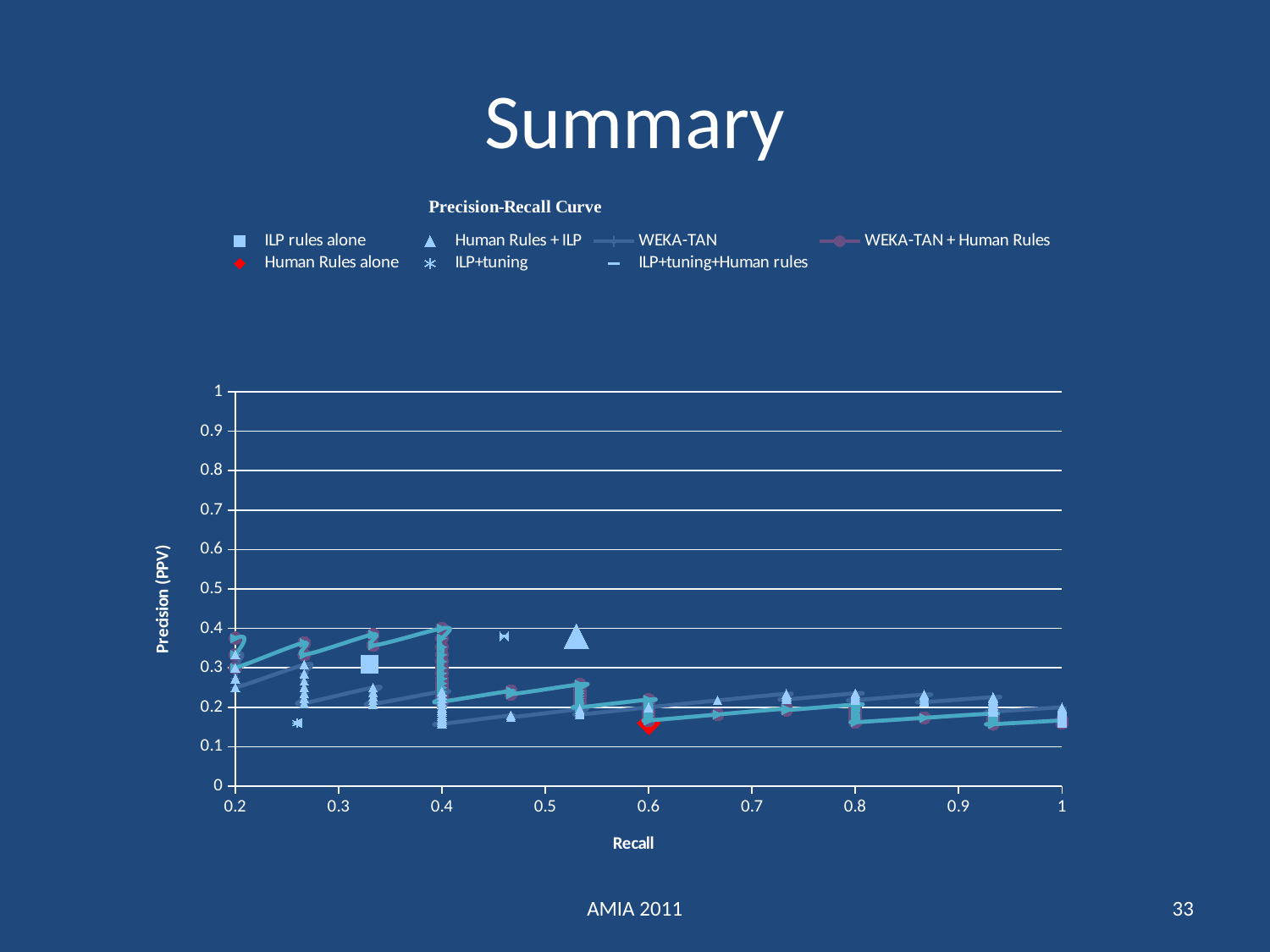
Is the precision value for Human Rules + ILP greater or less than 0.3? greater Do the precision values of the WEKA-TAN series generally rise or fall as recall increases? fall Is the precision value for Human Rules alone greater or less than 0.2? less Which has the higher precision, Human Rules + ILP or Human Rules alone? Human Rules + ILP Is the recall value for Human Rules alone greater or less than 0.5? greater How many series does the legend of the Precision-Recall Curve chart list? 7 Which has the higher recall, Human Rules alone or ILP+tuning? Human Rules alone What is the title of the chart on the slide? Precision-Recall Curve What is the label of the vertical axis of the chart? Precision (PPV) What kind of chart is shown on the slide? Scatter/line chart